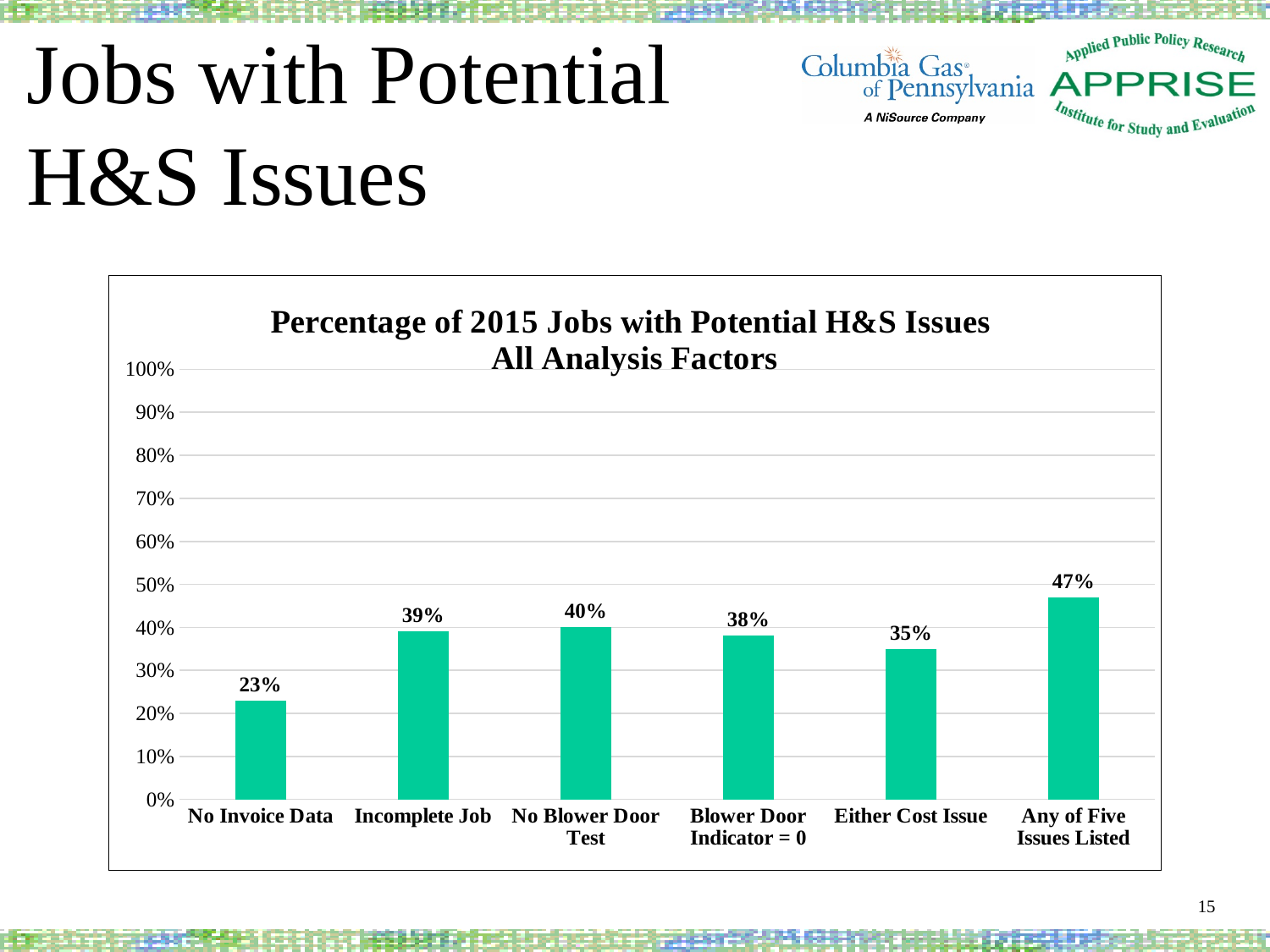
Is the value for Blower Door Indicator = 0 greater or less than 50%? less Which category has the highest percentage? Any of Five Issues Listed What percentage of 2015 jobs had No Invoice Data? 23% How many categories are shown on the x axis? 6 What kind of chart is shown on the slide? bar chart Which is larger, Incomplete Job or Either Cost Issue? Incomplete Job What is the value for Any of Five Issues Listed? 47% What is the title of the chart? Percentage of 2015 Jobs with Potential H&S Issues All Analysis Factors Which category has the lowest percentage? No Invoice Data What is the value for Either Cost Issue? 35% What is the difference between No Blower Door Test and Either Cost Issue? 5% What is the difference between Any of Five Issues Listed and No Invoice Data? 24%